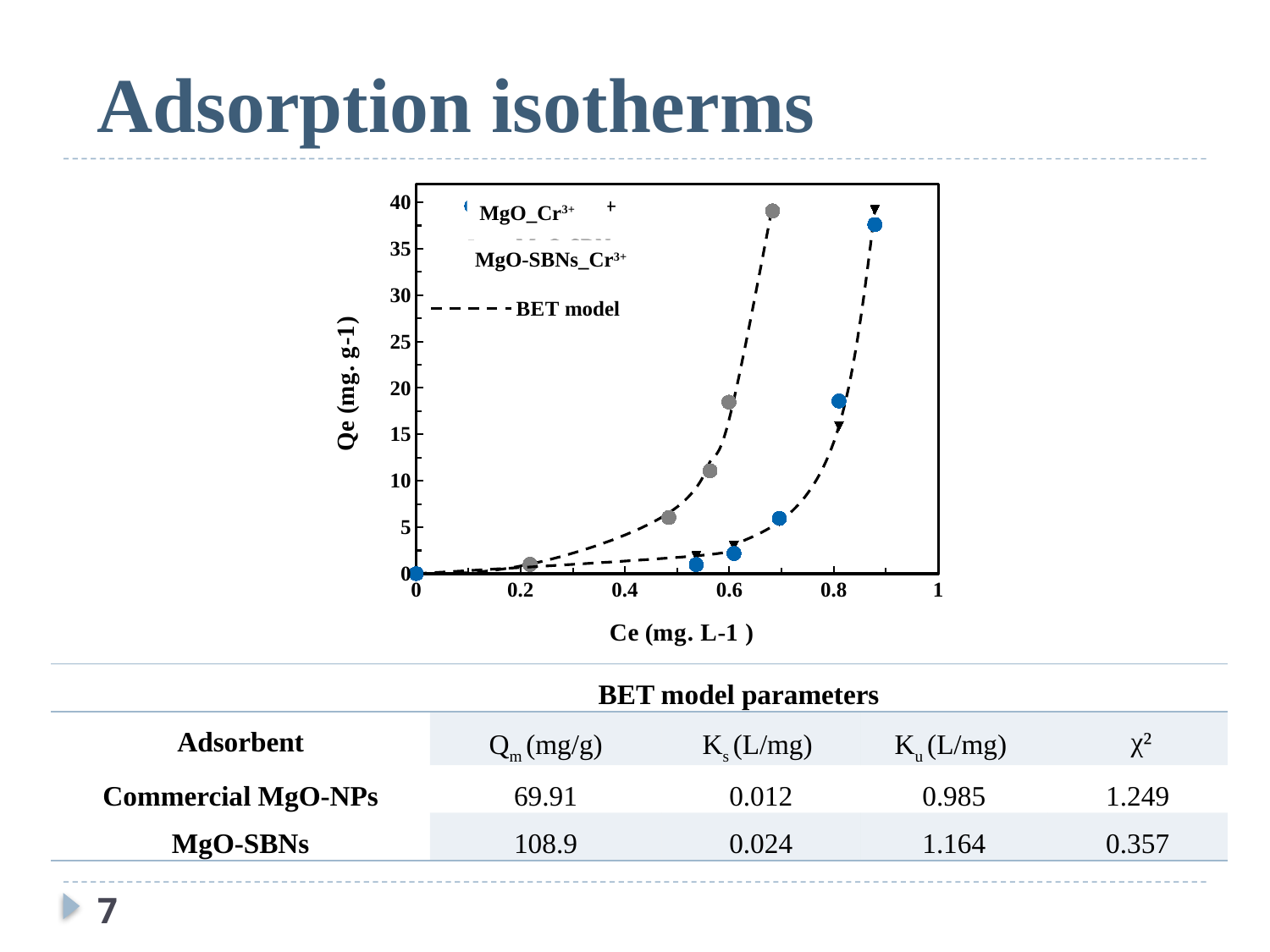
Is the highest Qe value plotted for the MgO-SBNs_Cr3+ series greater or less than 35? greater What kind of chart is shown on the slide? scatter chart Is the highest Qe value plotted for the MgO_Cr3+ series greater or less than 35? greater What is the label of the y axis of the chart? Qe (mg. g-1) What is the maximum value shown on the x axis of the chart? 1 Is the Qe value of the MgO-SBNs_Cr3+ point at Ce of about 0.6 greater or less than 15? greater Do the Qe values rise or fall as Ce increases along the x axis? rise What is the label of the x axis of the chart? Ce (mg. L-1 ) How many entries does the chart legend list? 3 At Ce of about 0.6, which series has the higher Qe value, MgO_Cr3+ or MgO-SBNs_Cr3+? MgO-SBNs_Cr3+ Which series reaches a Qe of 20 at a lower Ce value? MgO-SBNs_Cr3+